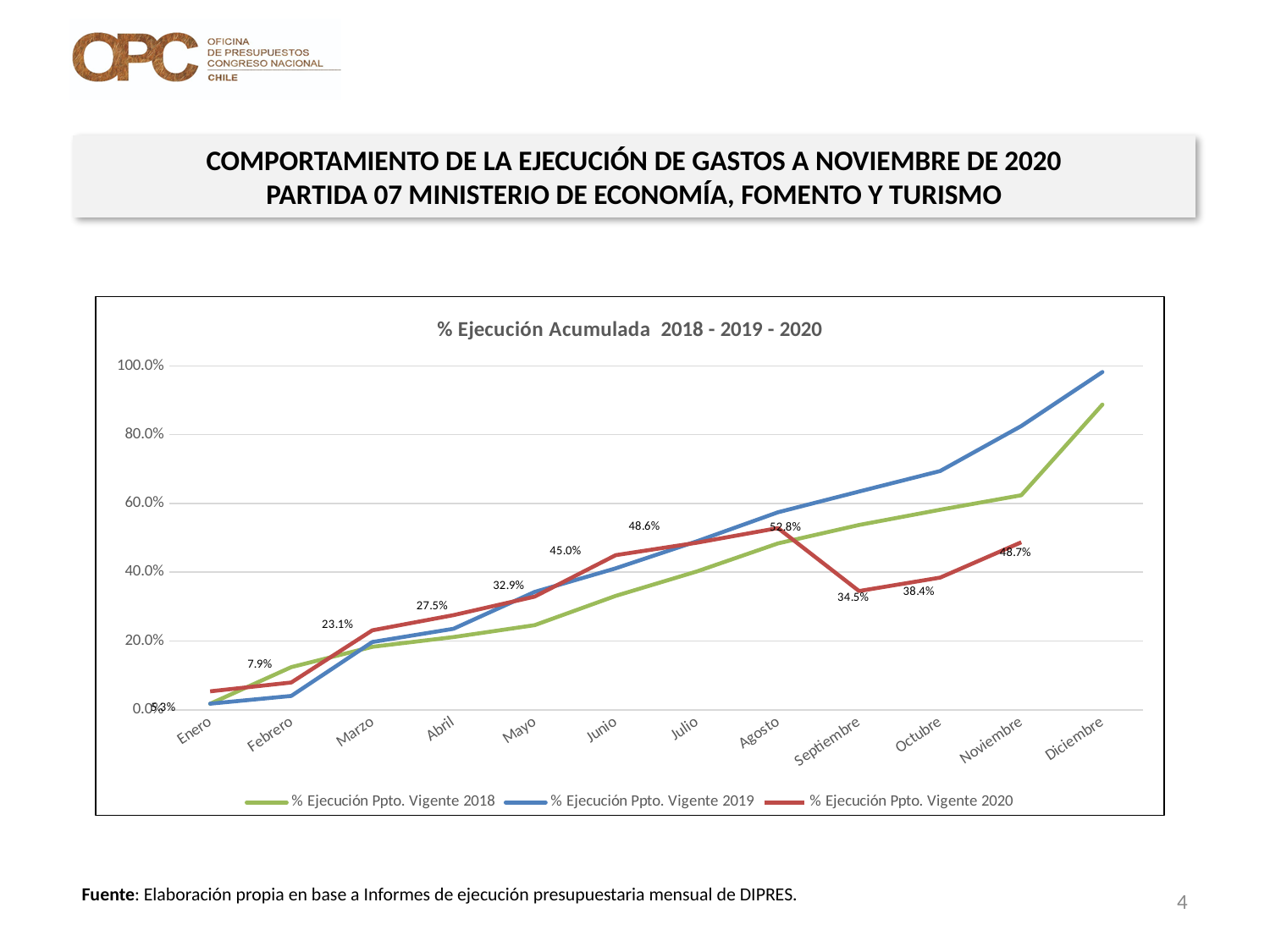
In which month does the % Ejecución Ppto. Vigente 2020 series reach its highest value? Agosto Which is larger in the % Ejecución Ppto. Vigente 2020 series, the value for Junio or the value for Julio? Julio Does the % Ejecución Ppto. Vigente 2019 series rise or fall from Enero to Diciembre? Rise How many series does the chart's legend list? 3 Is the value for Noviembre in the % Ejecución Ppto. Vigente 2018 series greater or less than 80.0%? less What is the value for Marzo in the % Ejecución Ppto. Vigente 2020 series? 23.1% What is the value for Agosto in the % Ejecución Ppto. Vigente 2020 series? 52.8% What is the value for Noviembre in the % Ejecución Ppto. Vigente 2020 series? 48.7% Is the value for Diciembre in the % Ejecución Ppto. Vigente 2019 series greater or less than 80.0%? greater How many months are shown on the x axis of the chart? 12 What is the difference between the Agosto and Septiembre values of the % Ejecución Ppto. Vigente 2020 series? 18.3 percentage points What kind of chart is shown on the slide? Line chart